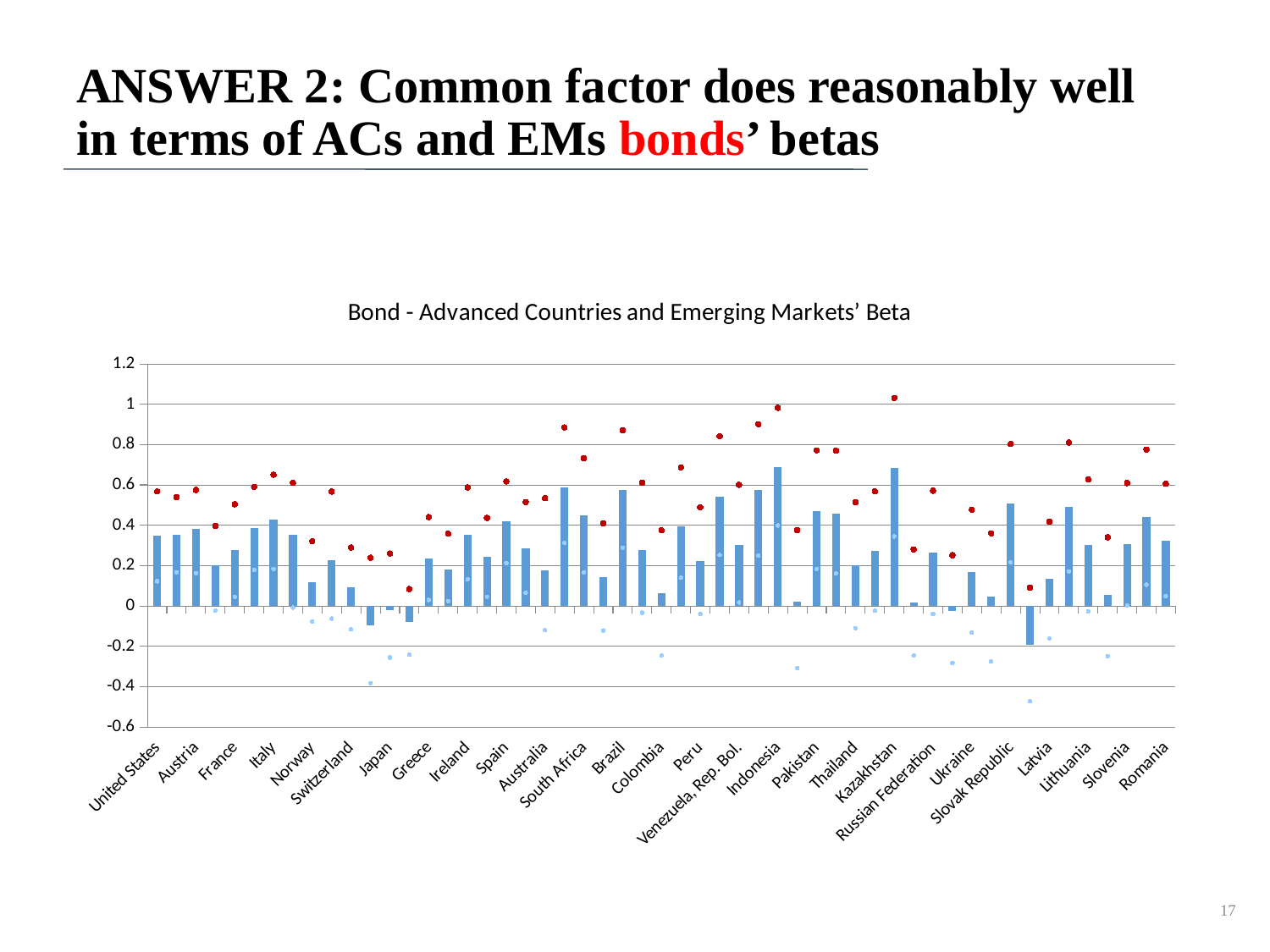
Which has the larger bar value, Italy or Japan? Italy What is the highest value shown on the vertical axis of the chart? 1.2 What is the title of the chart? Bond - Advanced Countries and Emerging Markets' Beta Is the bar value for Norway greater or less than 0.4? less Is the bar value for Japan greater or less than 0.2? less Is the bar value for Switzerland greater or less than 0.4? less Which of the labelled countries has the lowest bar value? Japan What kind of chart is shown on the slide? bar chart